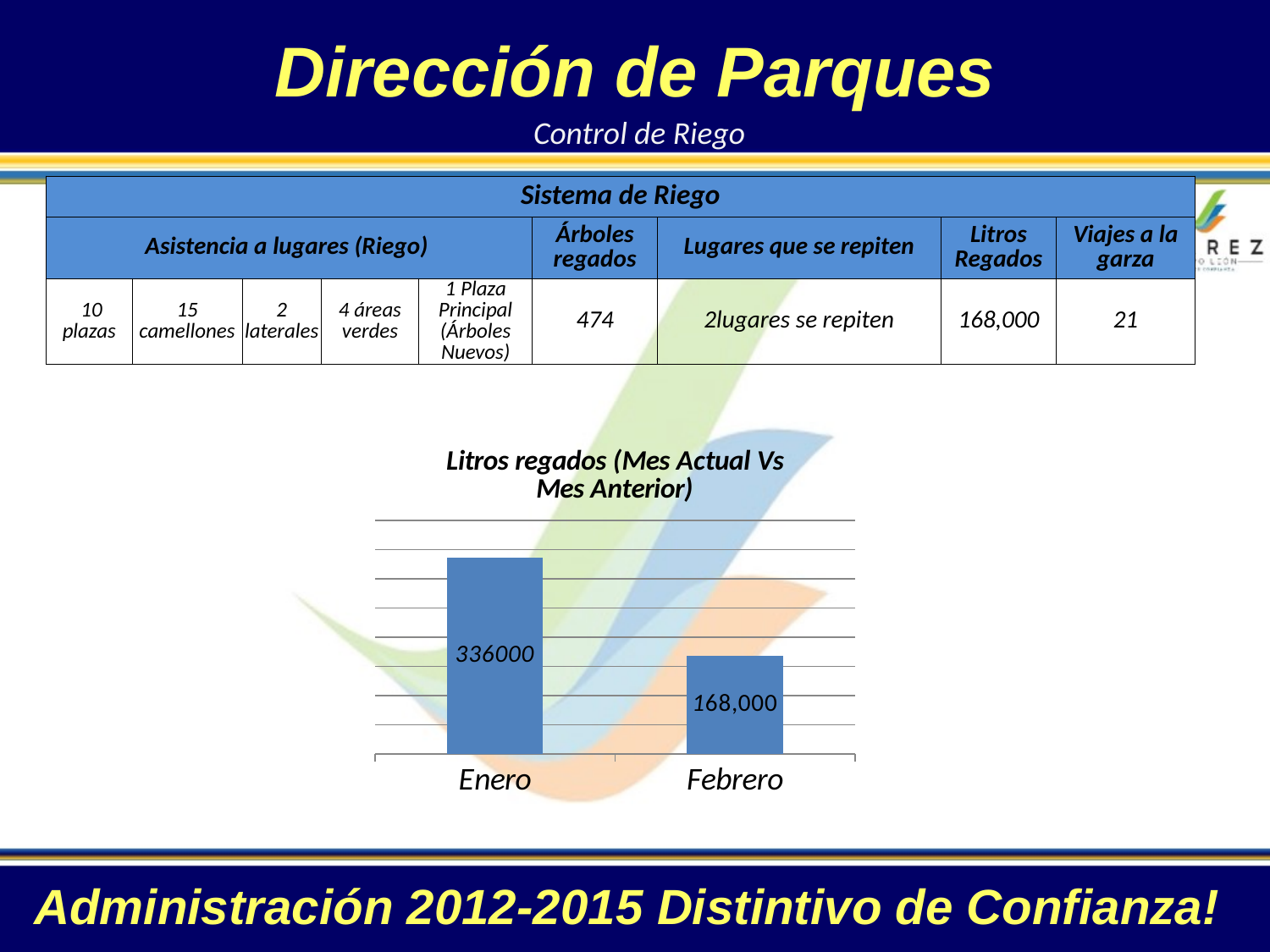
What kind of chart is shown on the slide? Bar chart Which month has the lowest value in the chart? Febrero What is the difference between the values for Enero and Febrero? 168,000 What is the value for Enero in the chart? 336000 Which month appears on the left side of the chart's x axis? Enero What is the value for Febrero in the chart? 168,000 Which is larger, the value for Enero or the value for Febrero? Enero Do the values rise or fall from Enero to Febrero? Fall Which month has the highest value in the chart? Enero How many categories are shown on the x axis of the chart? 2 What is the title of the chart? Litros regados (Mes Actual Vs Mes Anterior)